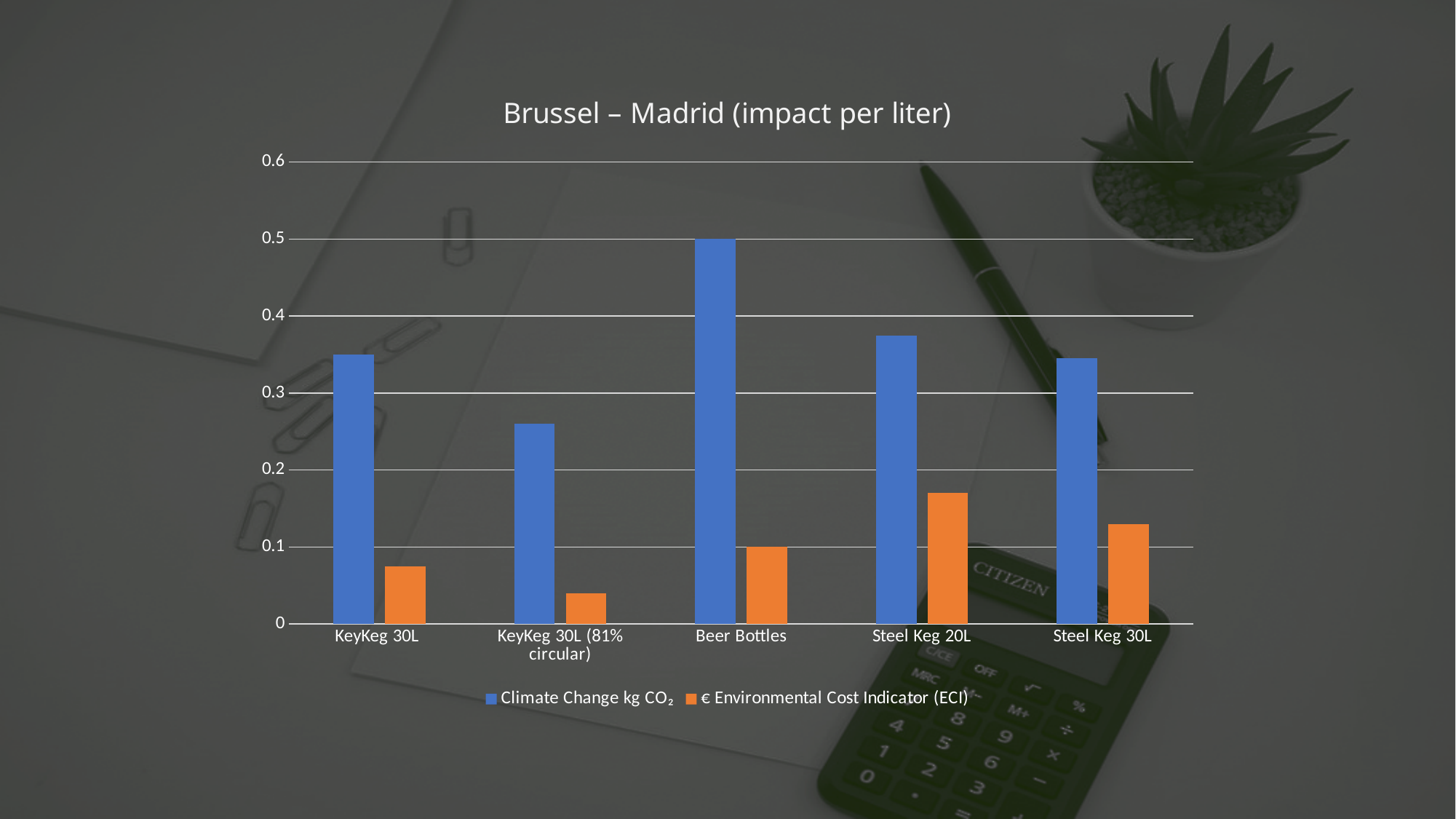
What type of chart is shown on the slide? bar chart Is the Climate Change kg CO₂ value for KeyKeg 30L (81% circular) greater or less than 0.3? less Which category has the lowest € Environmental Cost Indicator (ECI) value? KeyKeg 30L (81% circular) Which category has the highest € Environmental Cost Indicator (ECI) value? Steel Keg 20L Which category has the lowest Climate Change kg CO₂ value? KeyKeg 30L (81% circular) Which category has the highest Climate Change kg CO₂ value? Beer Bottles How many series does the legend list? 2 How many categories are shown on the x axis? 5 What is the € Environmental Cost Indicator (ECI) value for Beer Bottles? 0.1 What is the Climate Change kg CO₂ value for Beer Bottles? 0.5 What is the title of the chart? Brussel – Madrid (impact per liter) Which has the larger € Environmental Cost Indicator (ECI) value, Steel Keg 20L or Steel Keg 30L? Steel Keg 20L